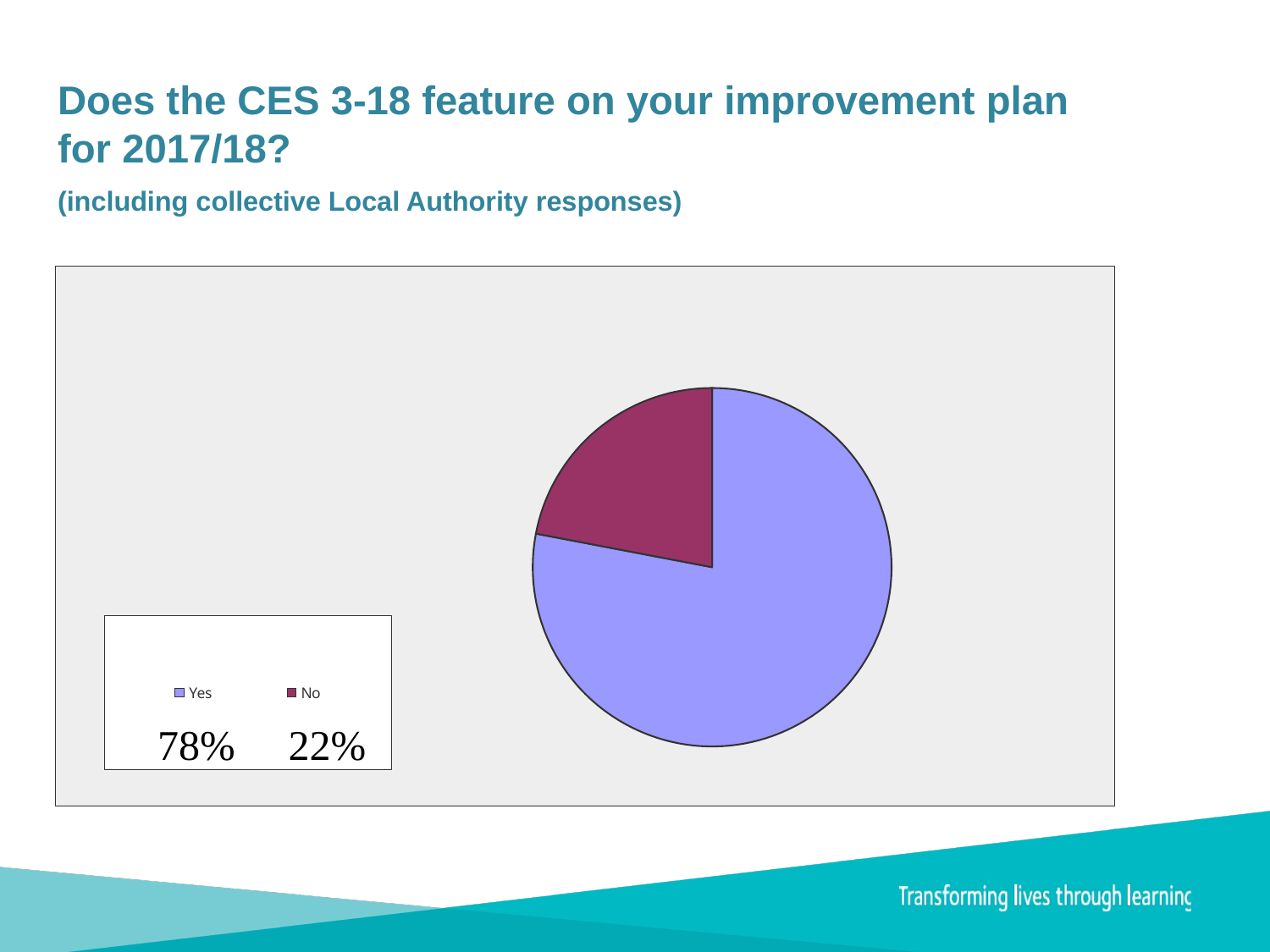
What percentage of responses were "No"? 22% How many categories does the pie chart show? 2 What share of the pie does the "No" slice represent? 22% Which response has the largest share of the pie? Yes What question does the chart title ask? Does the CES 3-18 feature on your improvement plan for 2017/18? What colour is the "Yes" slice of the pie? light blue/purple What is the difference in percentage points between the "Yes" and "No" shares? 56 Which is larger, the "Yes" share or the "No" share? Yes Which response has the smallest share of the pie? No What percentage of responses were "Yes"? 78% What kind of chart is shown on the slide? pie chart How many entries does the legend list? 2